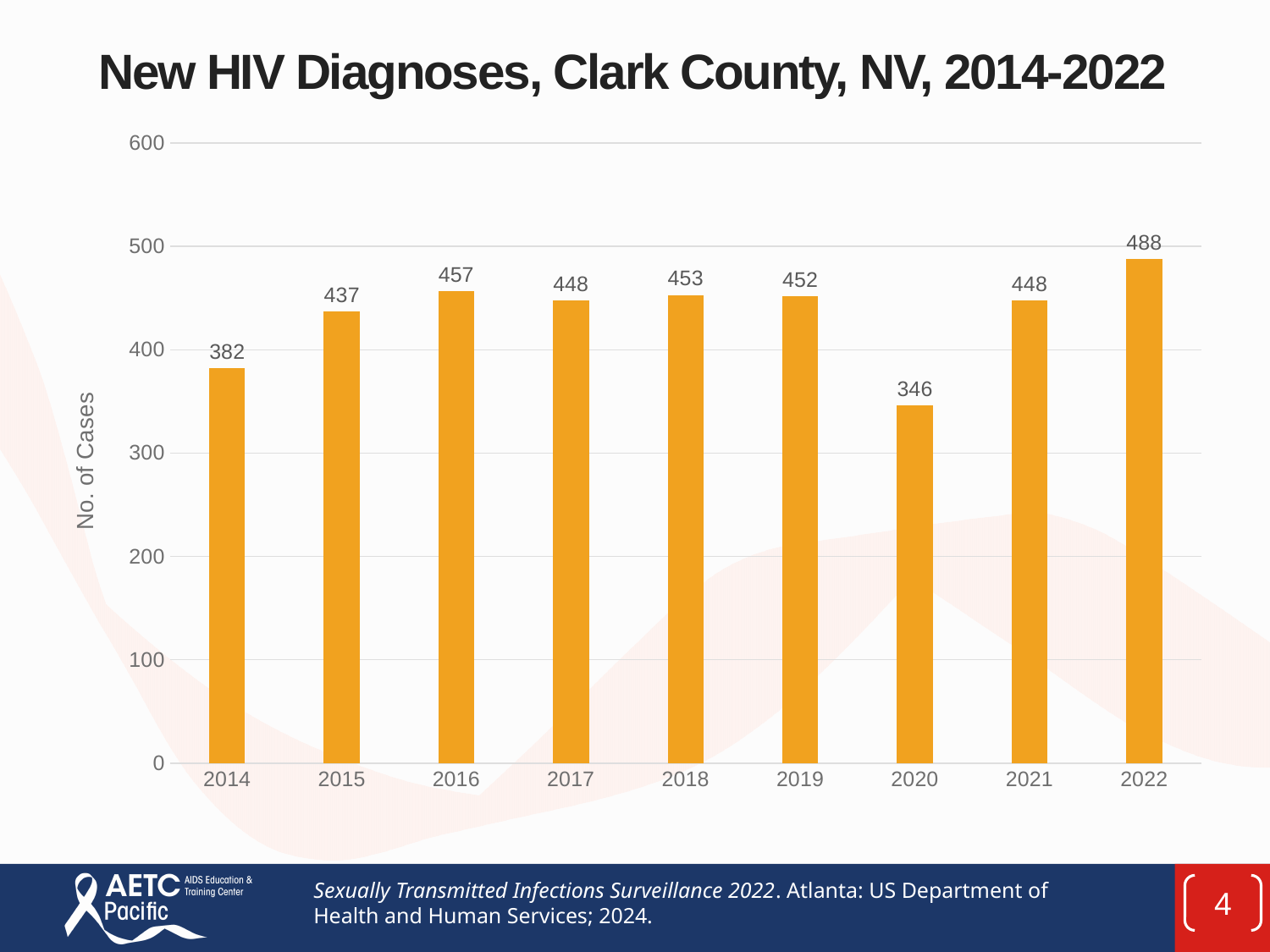
What is the difference in cases between 2015 and 2014? 55 Which year has the lowest number of new HIV diagnoses? 2020 How many years are shown on the x axis? 9 Which year had more cases, 2016 or 2019? 2016 Is the value for 2021 greater or less than 400? greater What kind of chart is shown on the slide? Bar chart How many new HIV diagnoses were reported in Clark County in 2014? 382 What is the label on the y axis? No. of Cases What value is shown for 2016? 457 What is the difference in cases between 2022 and 2020? 142 What is the number of cases shown for 2020? 346 Which year has the highest number of new HIV diagnoses? 2022